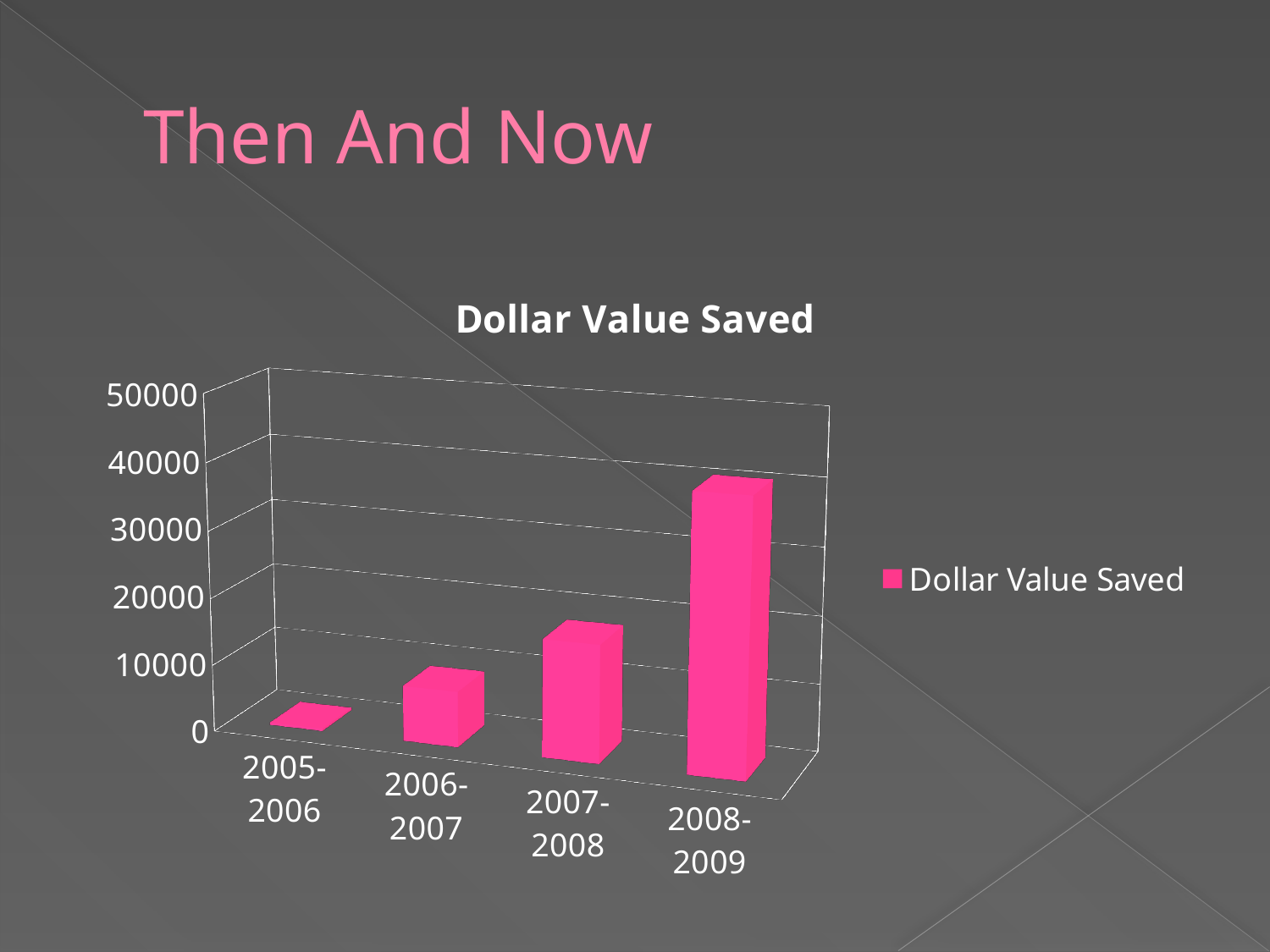
Which period has the highest dollar value saved? 2008-2009 Which is larger, the value for 2006-2007 or the value for 2005-2006? 2006-2007 Is the value for 2005-2006 greater or less than 10000? less How many categories are shown on the x axis of the chart? 4 Which period has the lowest dollar value saved? 2005-2006 Is the value for 2007-2008 greater or less than 30000? less Is the value for 2008-2009 greater or less than 30000? greater What kind of chart is shown on the slide? bar chart What is the title of the chart? Dollar Value Saved Which is larger, the value for 2008-2009 or the value for 2007-2008? 2008-2009 Do the values rise or fall from 2005-2006 to 2008-2009? rise How many series does the legend list? 1